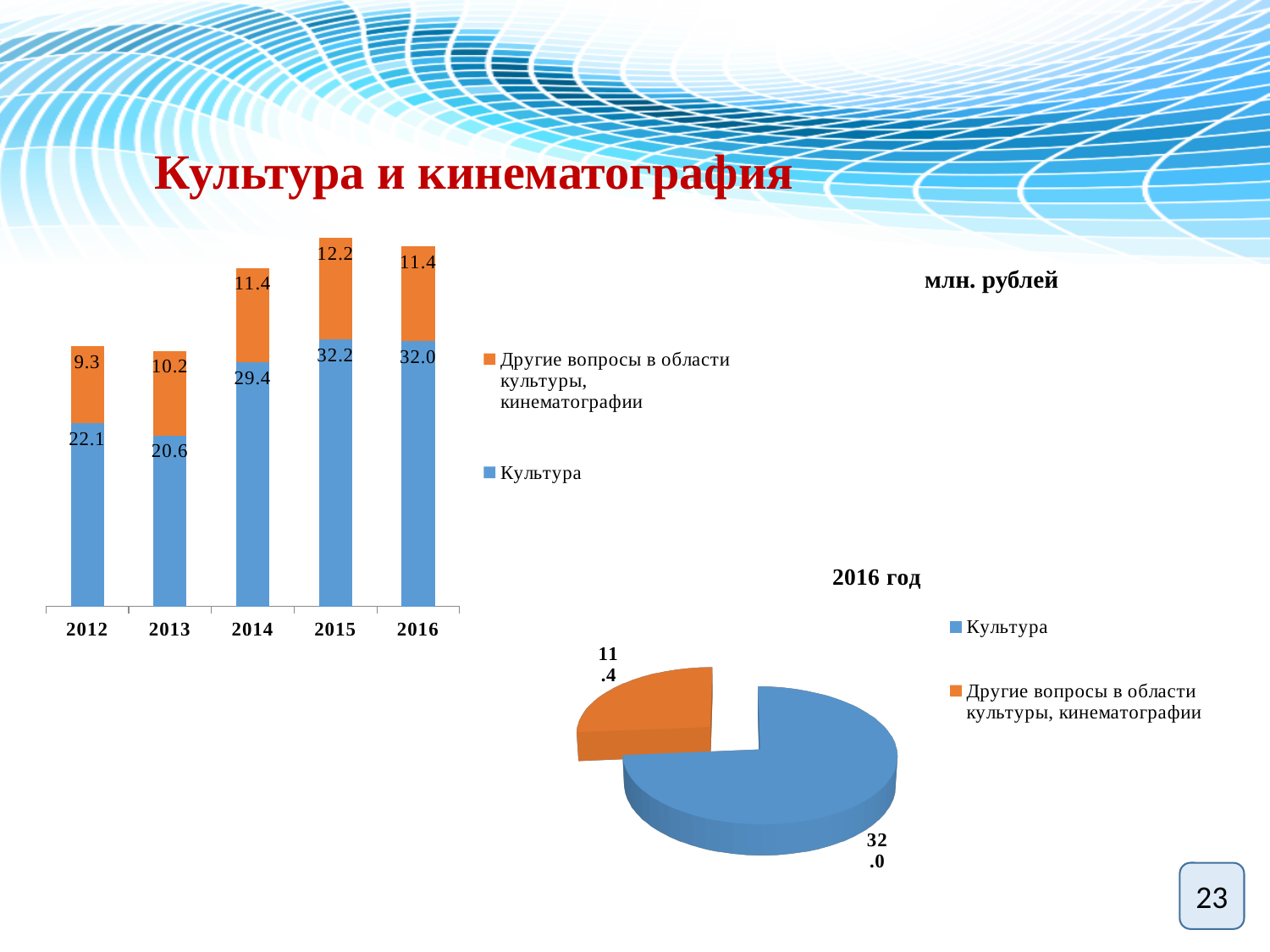
In the stacked bar chart on the left, which year has the lowest value for Другие вопросы в области культуры, кинематографии? 2012 What kind of chart is the chart titled 2016 год? Pie chart How many years are shown on the x axis of the stacked bar chart on the left? 5 In the pie chart titled 2016 год, what is the value for Другие вопросы в области культуры, кинематографии? 11.4 How many series does the legend of the stacked bar chart on the left list? 2 In the stacked bar chart on the left, what is the value for Культура in 2014? 29.4 In the stacked bar chart on the left, which is larger: the Культура value for 2012 or for 2013? 2012 In the stacked bar chart on the left, what is the total of the stacked bar for 2015? 44.4 In the pie chart titled 2016 год, which slice is larger: Культура or Другие вопросы в области культуры, кинематографии? Культура In the stacked bar chart on the left, which year has the highest value for Культура? 2015 In the stacked bar chart on the left, what is the value for Другие вопросы в области культуры, кинематографии in 2015? 12.2 In the stacked bar chart on the left, what is the difference between the Культура values for 2014 and 2013? 8.8